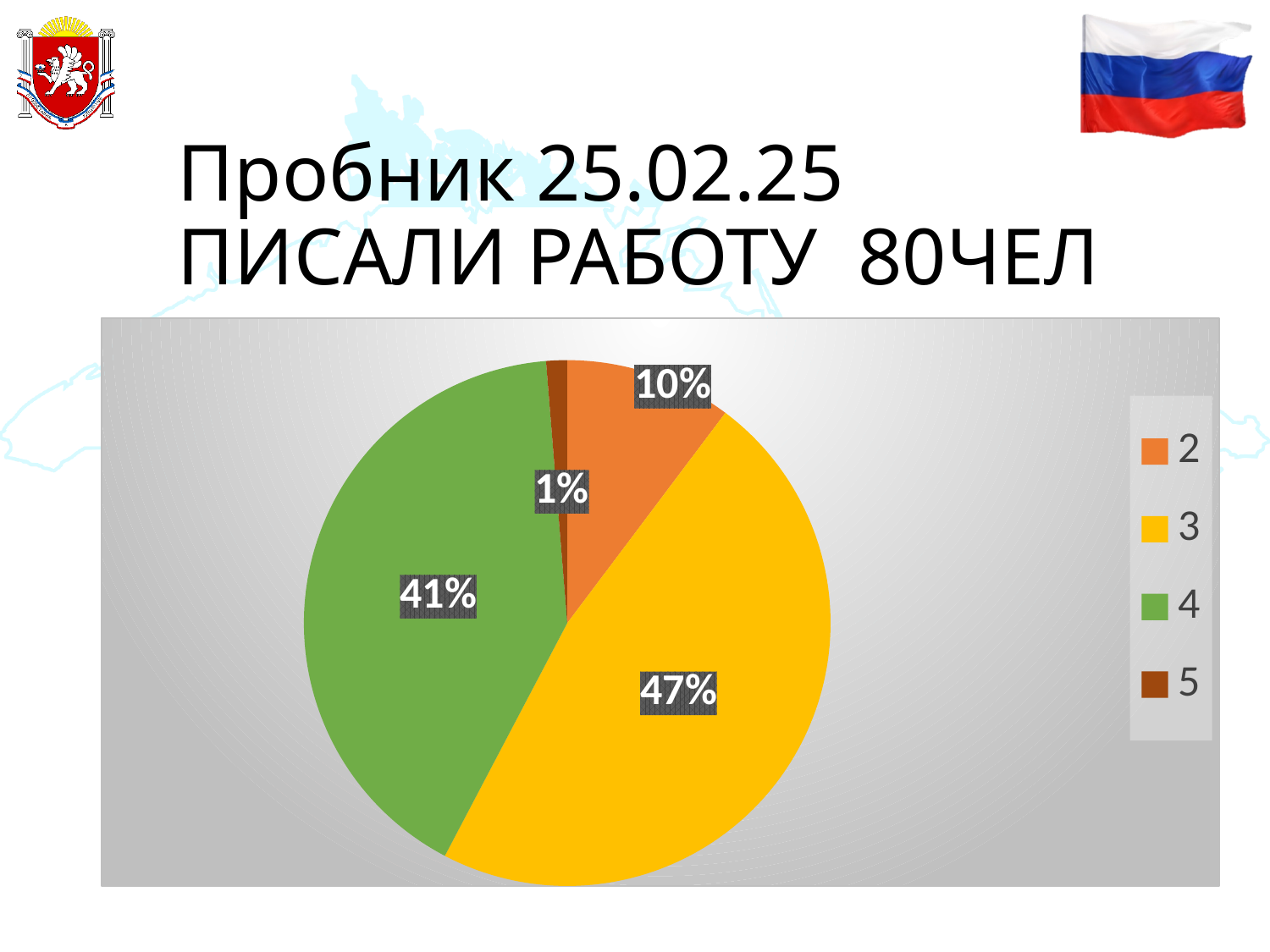
Which category has the smallest slice of the pie? 5 What is the difference in percentage points between the slices for category 3 and category 4? 6% Which slice is larger, category 2 or category 4? 4 What share of the pie does category 2 have? 10% How many categories does the legend list? 4 What colour is the slice for category 3? yellow What share of the pie does category 3 have? 47% What share of the pie does category 5 have? 1% What kind of chart is shown on the slide? pie chart Which category has the largest slice of the pie? 3 What is the difference in percentage points between the slices for category 2 and category 5? 9%